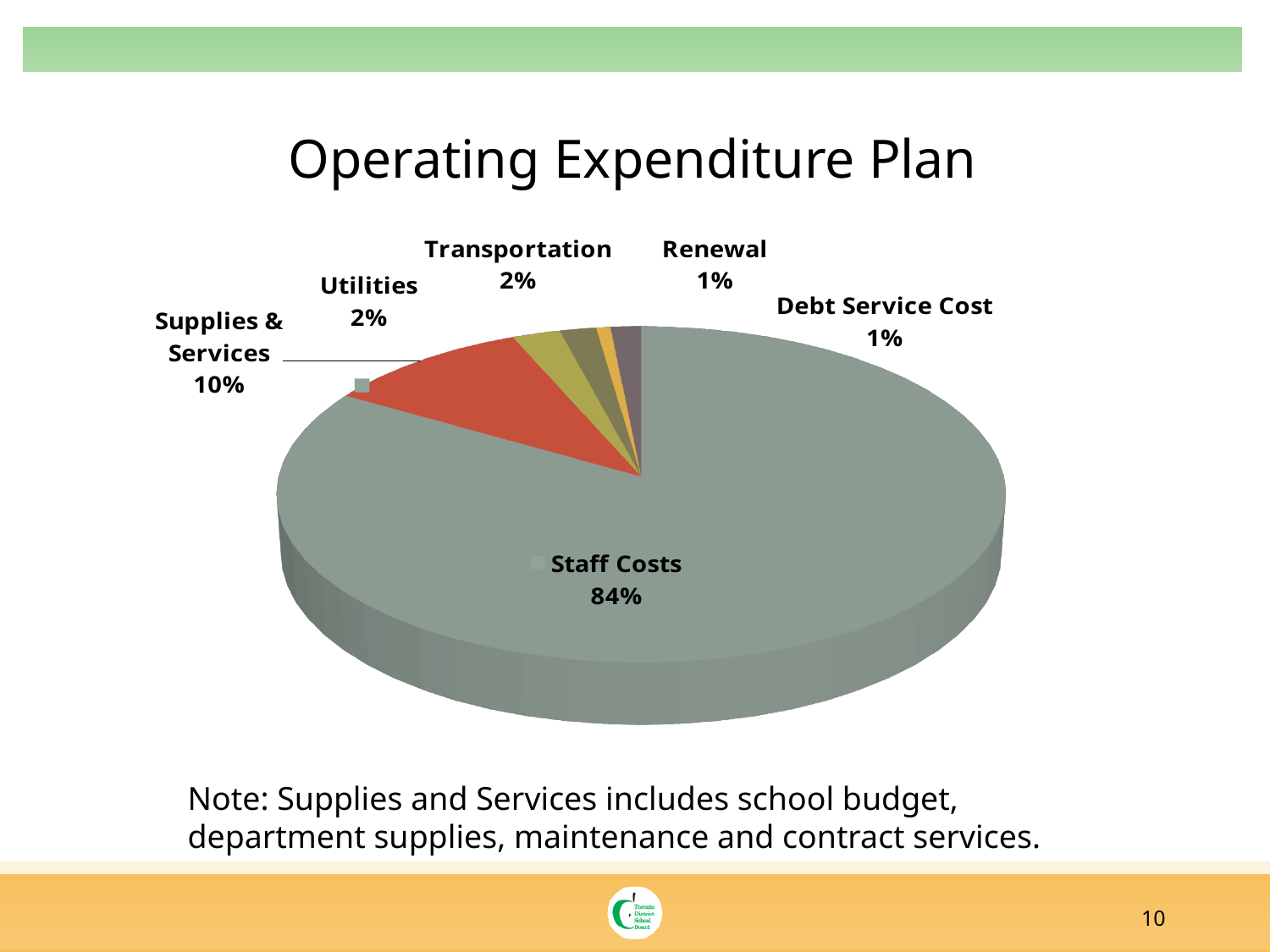
Which category has the largest slice of the pie? Staff Costs What is the difference in percentage points between Staff Costs and Supplies & Services? 74 What percentage is shown for Debt Service Cost? 1% What share of the Operating Expenditure Plan pie is Staff Costs? 84% What percentage is shown for Utilities? 2% What percentage is shown for Supplies & Services? 10% How many categories are shown in the pie chart? 6 What kind of chart is shown on the slide? Pie chart What is the combined percentage of Renewal and Debt Service Cost? 2% Which is larger, Supplies & Services or Utilities? Supplies & Services What percentage is shown for Transportation? 2% What is the title of the chart on the slide? Operating Expenditure Plan